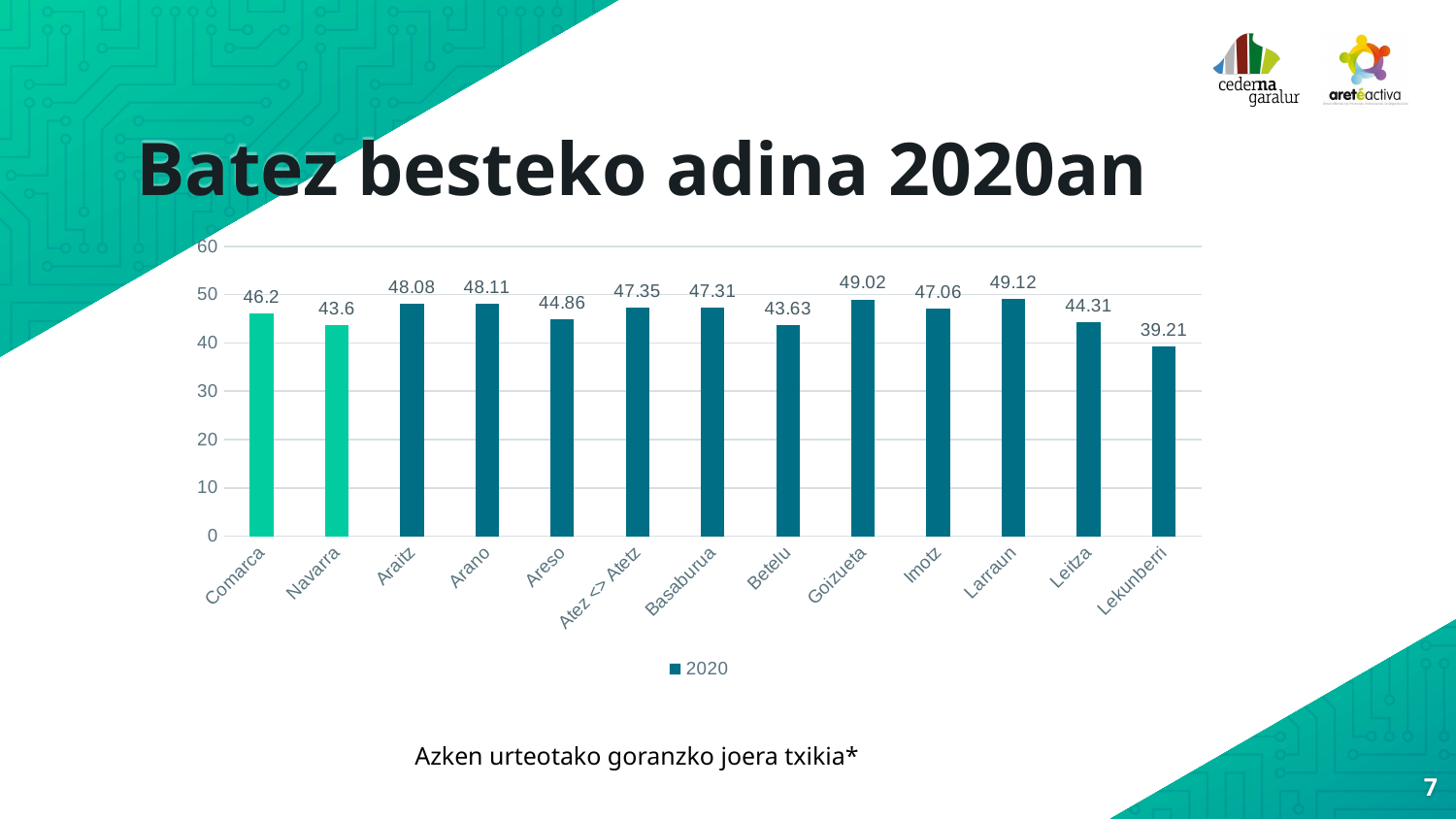
Which is larger, the value for Goizueta or the value for Leitza? Goizueta What is the value for Lekunberri? 39.21 How many series does the legend list? 1 How many categories are shown on the x axis? 13 What is the difference between the values for Larraun and Lekunberri? 9.91 What kind of chart is shown on the slide? bar chart Which category has the highest value? Larraun Is the value for Lekunberri greater or less than 40? less What is the difference between the values for Comarca and Navarra? 2.6 What is the value for Goizueta? 49.02 What is the value for Comarca? 46.2 Which category has the lowest value? Lekunberri